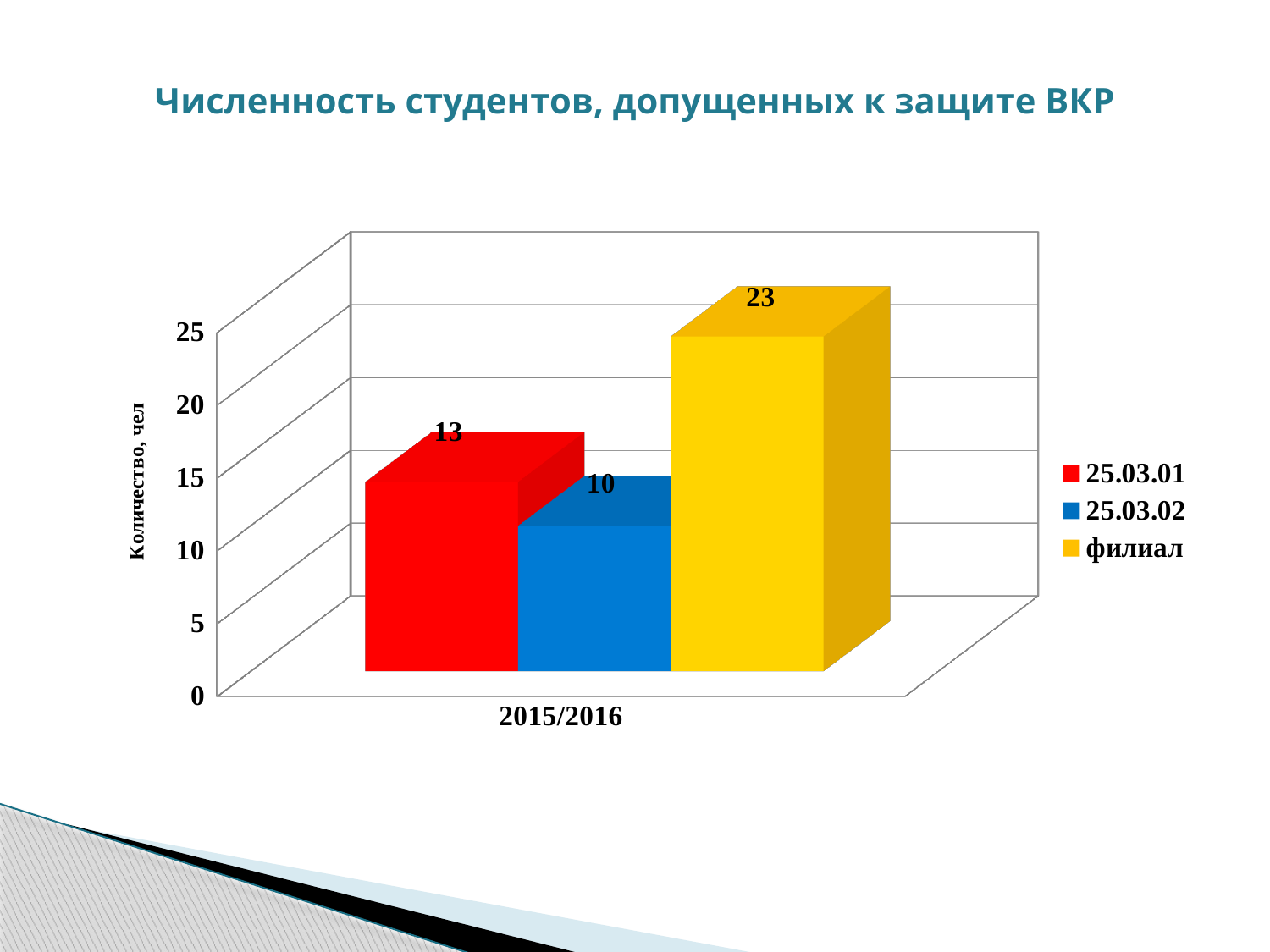
Is the value for филиал greater or less than 20? greater Which series has the lowest value in 2015/2016? 25.03.02 What is the value for 25.03.01 in 2015/2016? 13 Which is larger, the value for 25.03.01 or the value for 25.03.02? 25.03.01 What is the difference between the values for филиал and 25.03.01? 10 How many series does the legend list? 3 What is the title of the chart? Численность студентов, допущенных к защите ВКР What is the difference between the values for 25.03.01 and 25.03.02? 3 What kind of chart is shown on the slide? bar chart What is the value for 25.03.02 in 2015/2016? 10 Which series has the highest value in 2015/2016? филиал What is the value for филиал in 2015/2016? 23